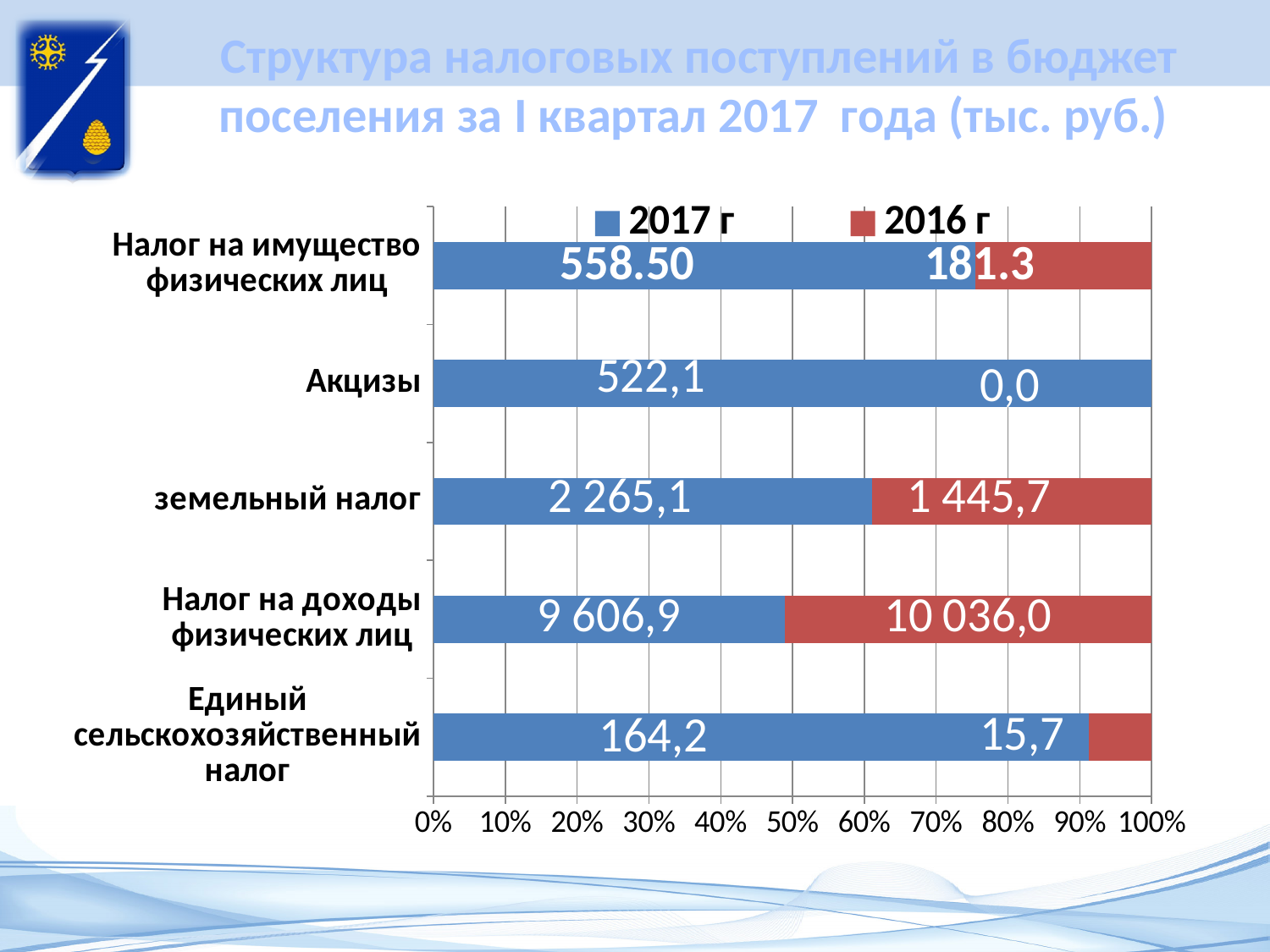
How many tax categories are shown on the chart? 5 Which is larger for Налог на доходы физических лиц: the 2017 г value or the 2016 г value? 2016 г How many series does the legend list? 2 What is the 2016 г value for Налог на доходы физических лиц? 10 036,0 What kind of chart is shown on the slide? bar chart What is the 2017 г value for Единый сельскохозяйственный налог? 164,2 What is the difference between the 2017 г and 2016 г values for земельный налог? 819,4 Is the 2017 г share of the bar for Налог на имущество физических лиц greater or less than 70%? greater What is the 2016 г value for Акцизы? 0,0 Which category has the lowest 2016 г value? Акцизы Which category has the highest 2017 г value? Налог на доходы физических лиц What is the 2017 г value for земельный налог? 2 265,1